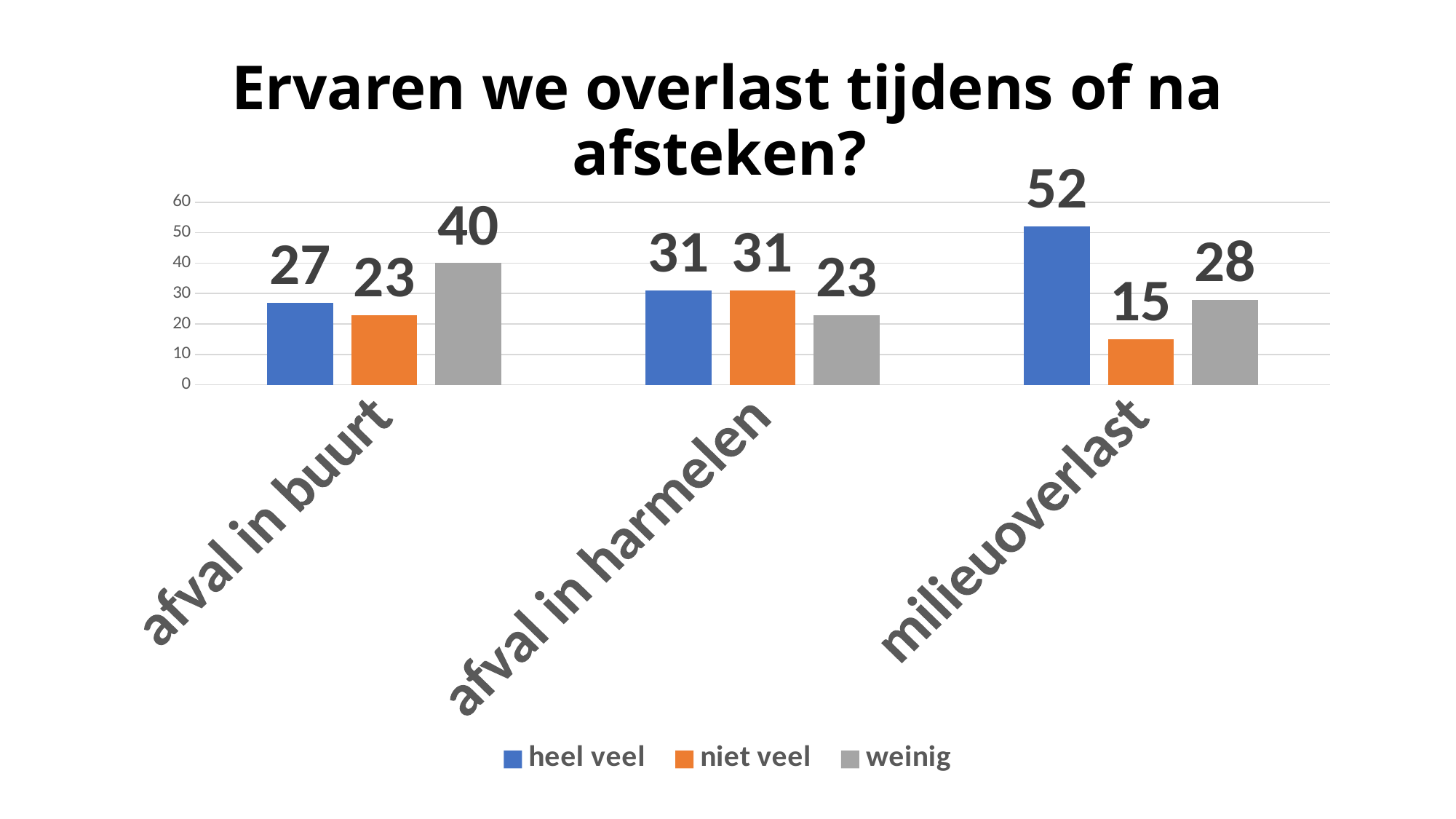
What is the value for 'weinig' in the 'milieuoverlast' category? 28 Which category has the lowest 'niet veel' value? milieuoverlast Which category has the highest 'heel veel' value? milieuoverlast How many categories are shown on the x axis? 3 What is the title of the chart? Ervaren we overlast tijdens of na afsteken? How many series does the legend list? 3 Which is larger for 'afval in buurt': 'heel veel' or 'weinig'? weinig What is the difference between the 'heel veel' and 'niet veel' values for 'milieuoverlast'? 37 What is the value for 'heel veel' in the 'afval in buurt' category? 27 What is the value for 'niet veel' in the 'afval in harmelen' category? 31 What kind of chart is shown on the slide? bar chart Is the 'heel veel' value for 'milieuoverlast' greater or less than 50? greater